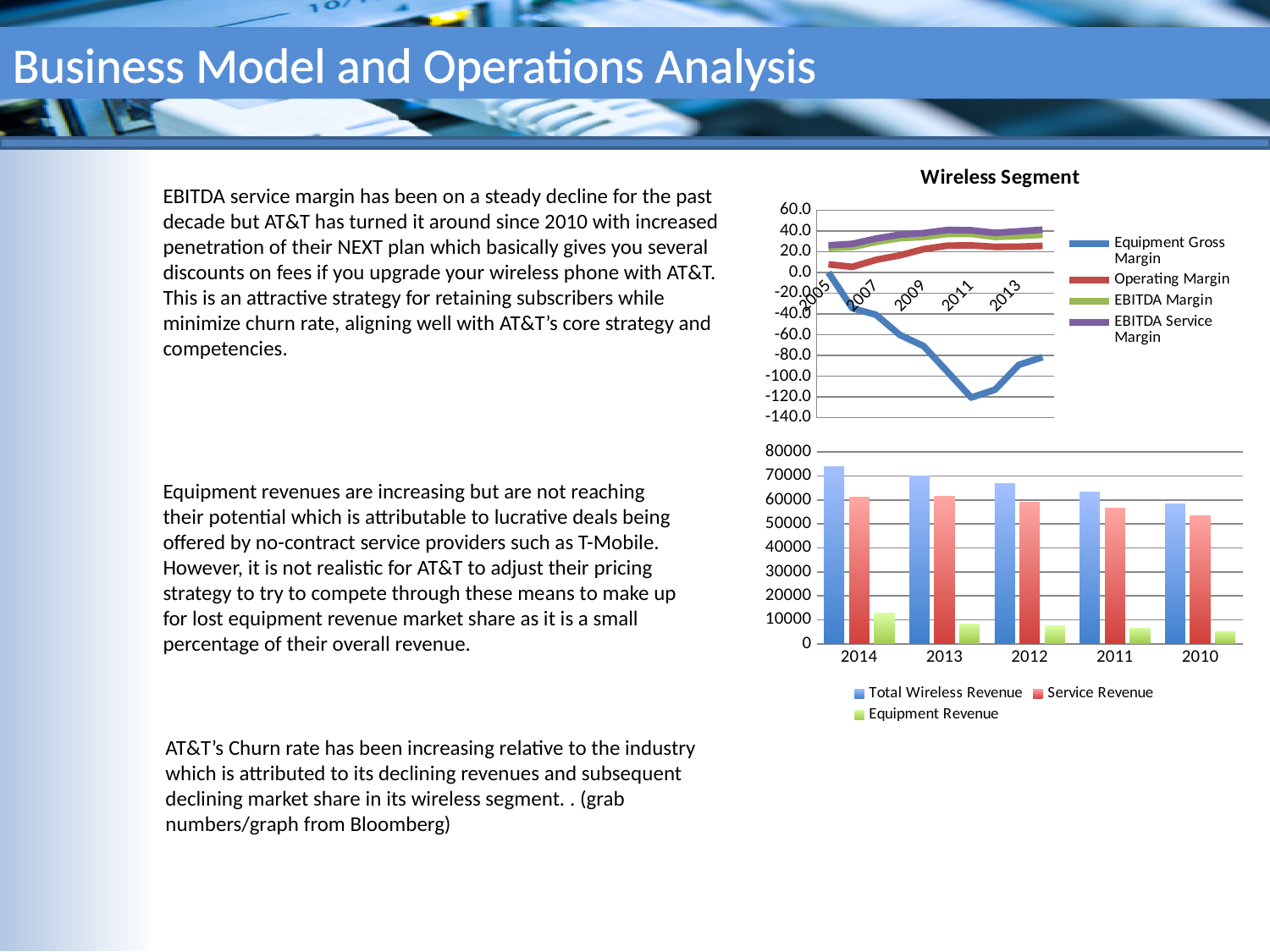
In the bottom bar chart, is Equipment Revenue for 2014 larger than Equipment Revenue for 2013? Yes, 2014 is larger How many years are shown on the x axis of the bottom bar chart? 5 In the bottom bar chart, is Total Wireless Revenue for 2014 greater or less than 70000? greater What type of chart is the top chart titled "Wireless Segment"? Line chart In the bottom bar chart, which year has the lowest Equipment Revenue? 2010 What type of chart is the bottom chart on the slide? Bar chart How many series does the legend of the bottom bar chart list? 3 In the bottom bar chart, which year has the highest Total Wireless Revenue? 2014 How many series does the legend of the top "Wireless Segment" chart list? 4 In the top "Wireless Segment" chart, is the EBITDA Service Margin for 2013 greater or less than 20.0? greater In the bottom bar chart, does Total Wireless Revenue rise or fall moving left to right from 2014 to 2010? Fall In the bottom bar chart, is Service Revenue for 2010 greater or less than 60000? less